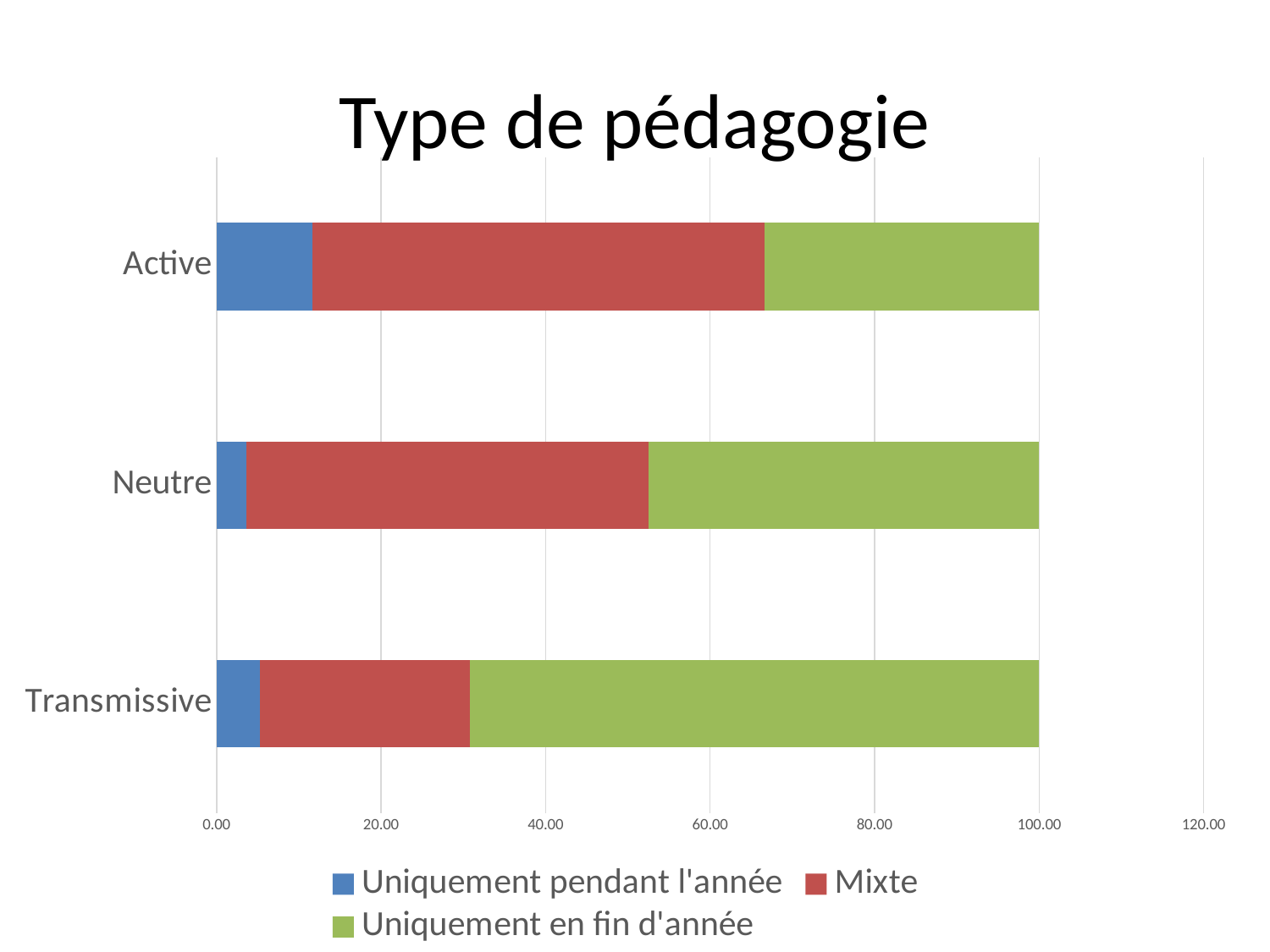
What is the total length of the stacked bar for Active? 100.00 Is the 'Uniquement en fin d'année' value for Transmissive greater or less than 60? greater What is the title of the chart? Type de pédagogie Which category has the largest Mixte segment? Active Is the Mixte value for Transmissive greater or less than 40? less Is the Mixte value for Active greater or less than 40? greater Which is larger: the 'Uniquement pendant l'année' segment for Active or for Neutre? Active Which category has the largest 'Uniquement en fin d'année' segment? Transmissive How many series does the legend list? 3 How many categories are shown on the vertical axis of the chart? 3 What kind of chart is shown on the slide? stacked bar chart